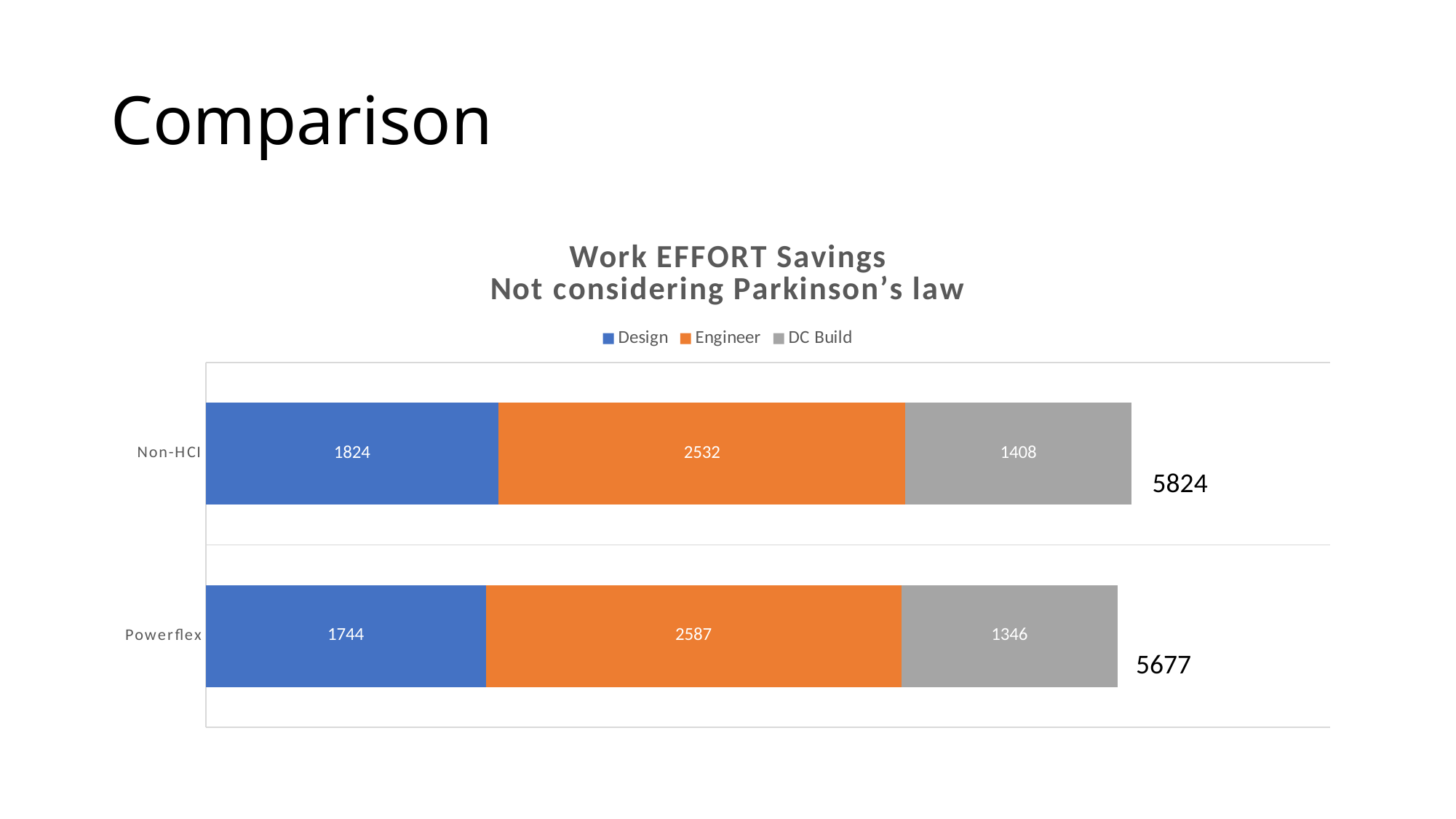
Which category has the larger Engineer value, Non-HCI or Powerflex? Powerflex What is the total of the stacked bar for Powerflex? 5677 What is the total of the stacked bar for Non-HCI? 5824 Which category has the higher total, Non-HCI or Powerflex? Non-HCI What is the DC Build value for Non-HCI? 1408 What is the Engineer value for Powerflex? 2587 What kind of chart is shown on the slide? Stacked bar chart What is the Design value for Non-HCI? 1824 How many series does the legend list? 3 What is the difference between the DC Build values for Non-HCI and Powerflex? 62 What is the difference between the Design values for Non-HCI and Powerflex? 80 Which series is shown in orange in the legend? Engineer